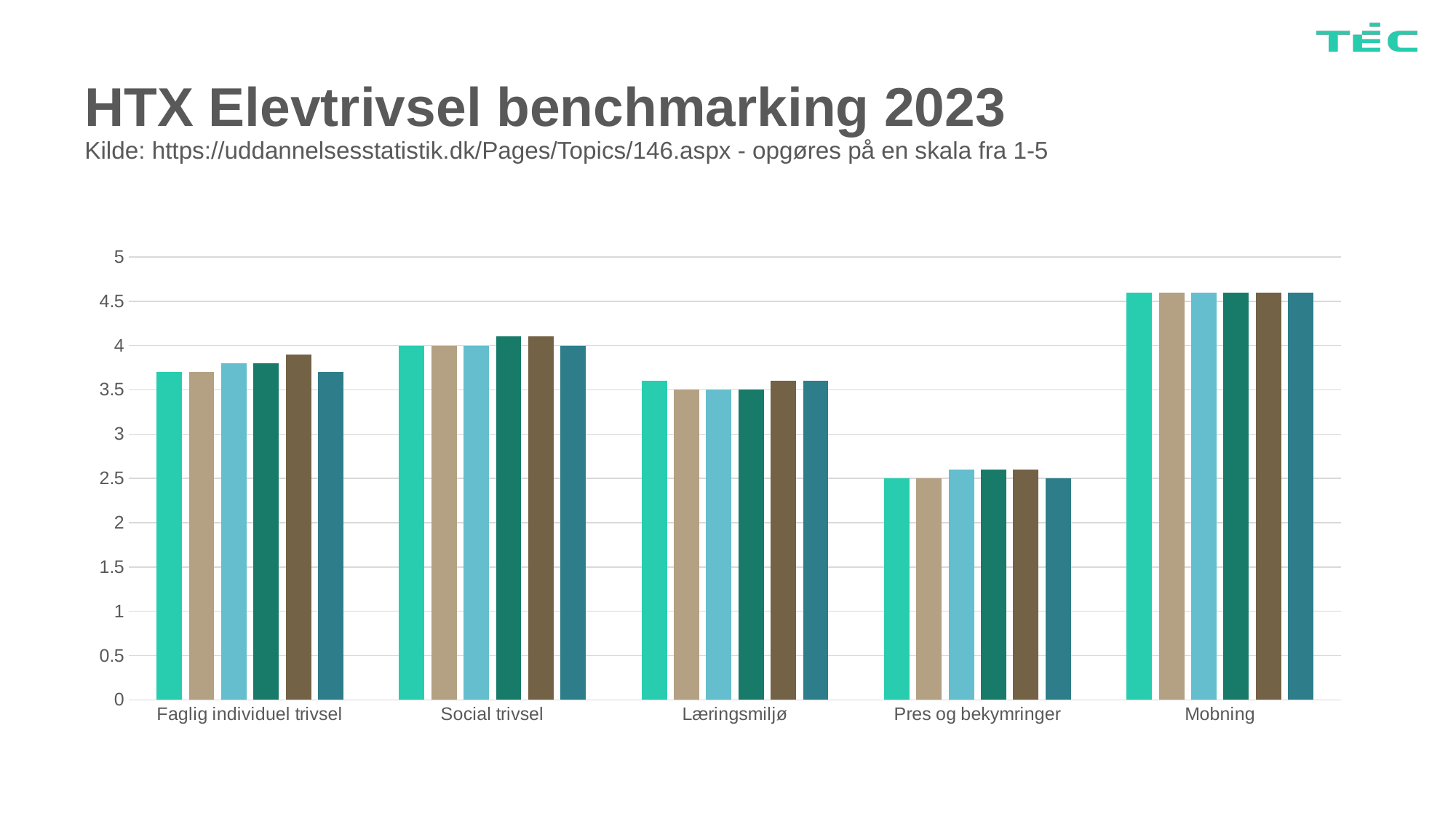
Which category has the lowest values in the chart? Pres og bekymringer Are the values for Mobning greater or less than 4? greater Which category has higher values, Mobning or Faglig individuel trivsel? Mobning Are the values for Pres og bekymringer greater or less than 3? less Which category has the highest values in the chart? Mobning Which category has higher values, Social trivsel or Læringsmiljø? Social trivsel What is the title of the slide containing the chart? HTX Elevtrivsel benchmarking 2023 What is the maximum value shown on the chart's y axis? 5 How many bars are plotted for each category in the chart? 6 Are the values for Faglig individuel trivsel greater or less than 3.5? greater How many categories are shown on the x axis of the chart? 5 What kind of chart is shown on the slide? bar chart